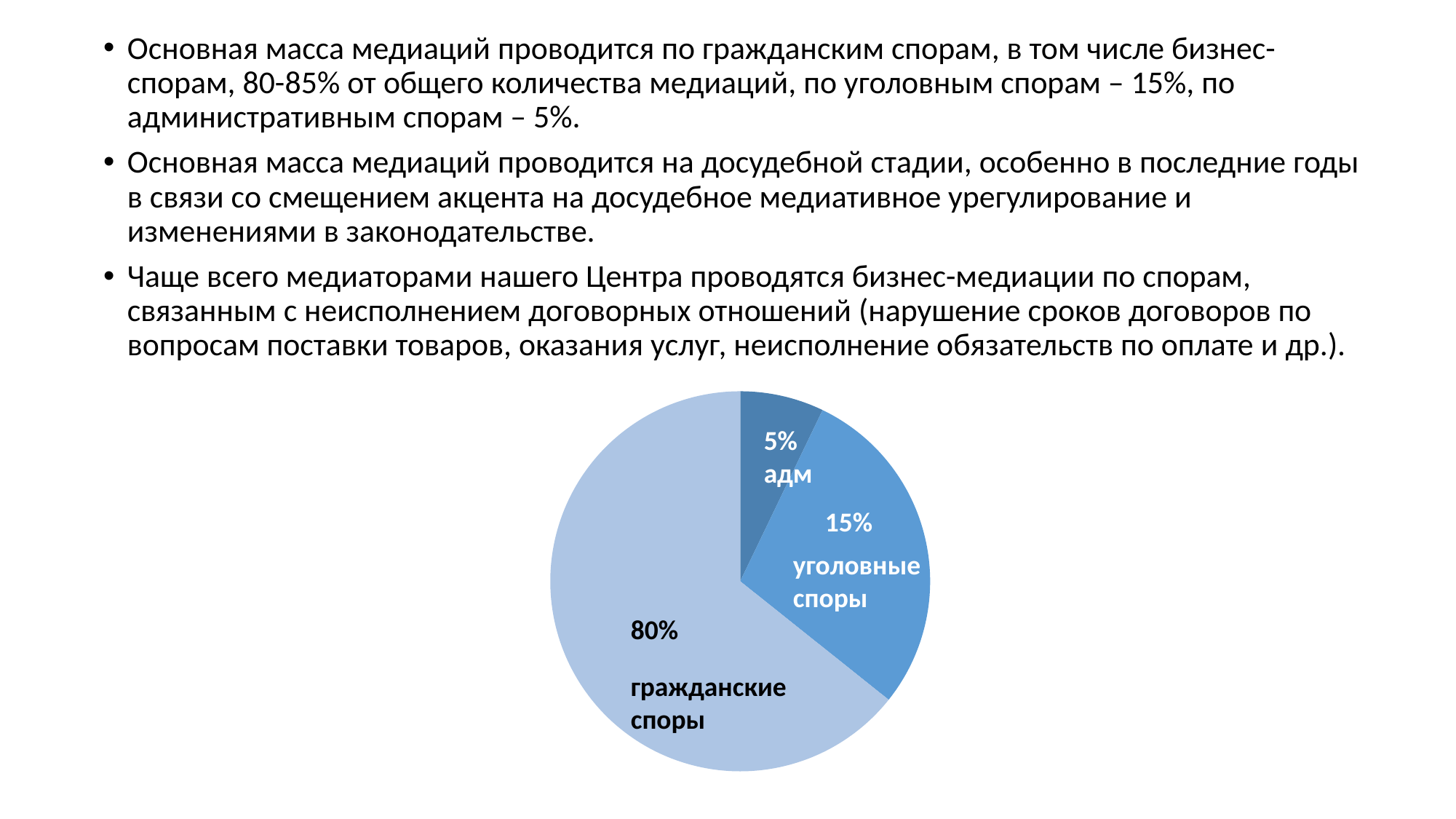
How many slices does the pie chart have? 3 Which slice of the pie chart is the smallest? адм What is the difference between the shares for "уголовные споры" and "адм"? 10% Which slice of the pie chart is drawn in the lightest shade of blue? гражданские споры What kind of chart is shown on the slide? pie chart Which slice of the pie chart is the largest? гражданские споры What share of the pie is labelled "уголовные споры"? 15% What is the combined share of "уголовные споры" and "адм"? 20% Which is larger: the share for "уголовные споры" or the share for "адм"? уголовные споры What is the difference between the shares for "гражданские споры" and "уголовные споры"? 65% What share of the pie is labelled "гражданские споры"? 80% What share of the pie is labelled "адм"? 5%